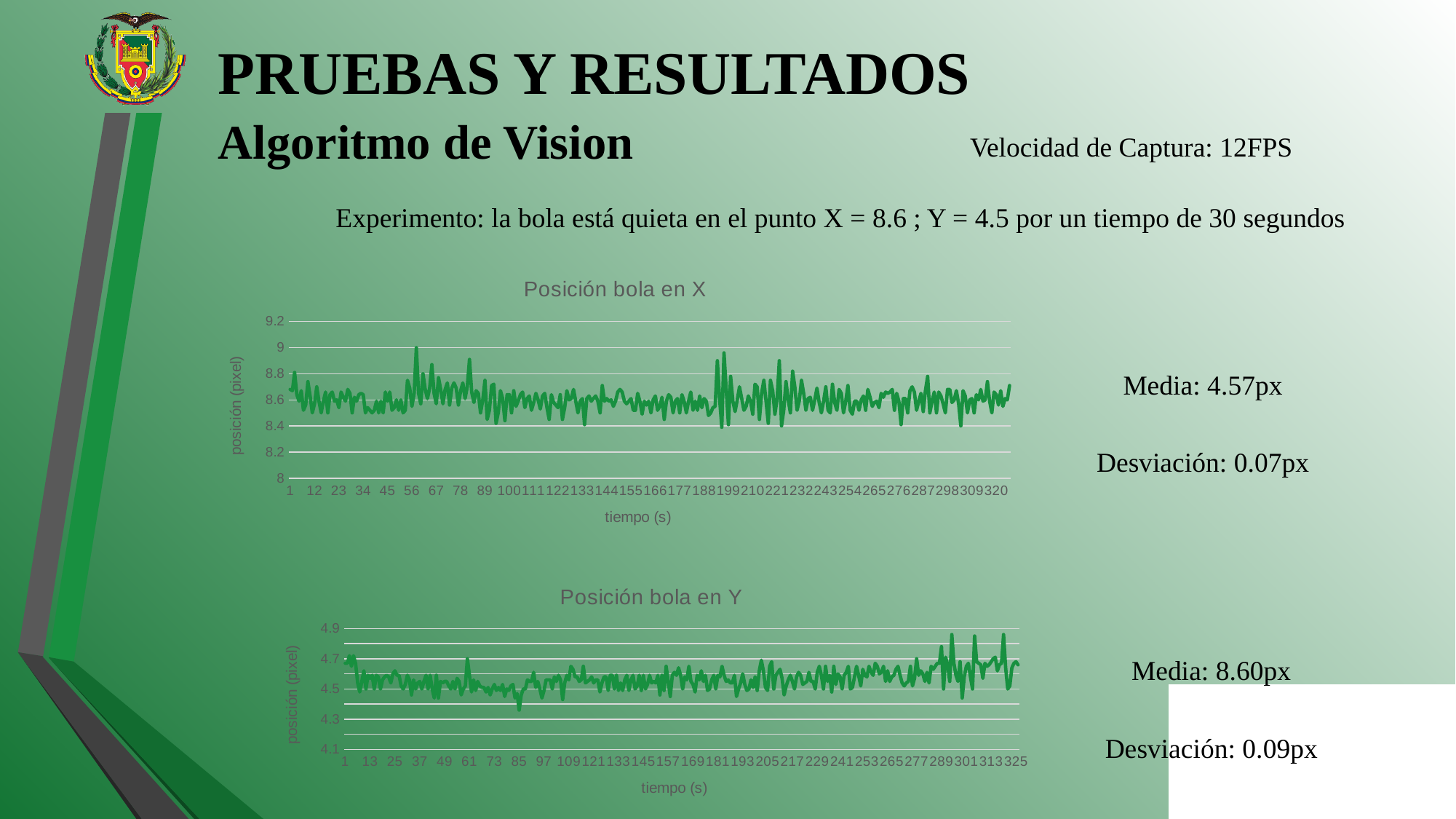
In the 'Posición bola en X' chart, is the value at time 1 greater or less than 8.4? greater In the 'Posición bola en Y' chart, is the highest plotted value greater or less than 4.9? less In the 'Posición bola en Y' chart, do the values show a clear rising or falling trend along the x axis, or stay roughly flat? roughly flat How many data series are plotted in the 'Posición bola en X' chart? 1 What is the x-axis label of the 'Posición bola en Y' chart? tiempo (s) What kind of chart is the 'Posición bola en Y' chart? line chart What is the title of the top chart on the slide? Posición bola en X In the 'Posición bola en X' chart, is the lowest plotted value greater or less than 8.2? greater How many data series are plotted in the 'Posición bola en Y' chart? 1 What kind of chart is the 'Posición bola en X' chart? line chart